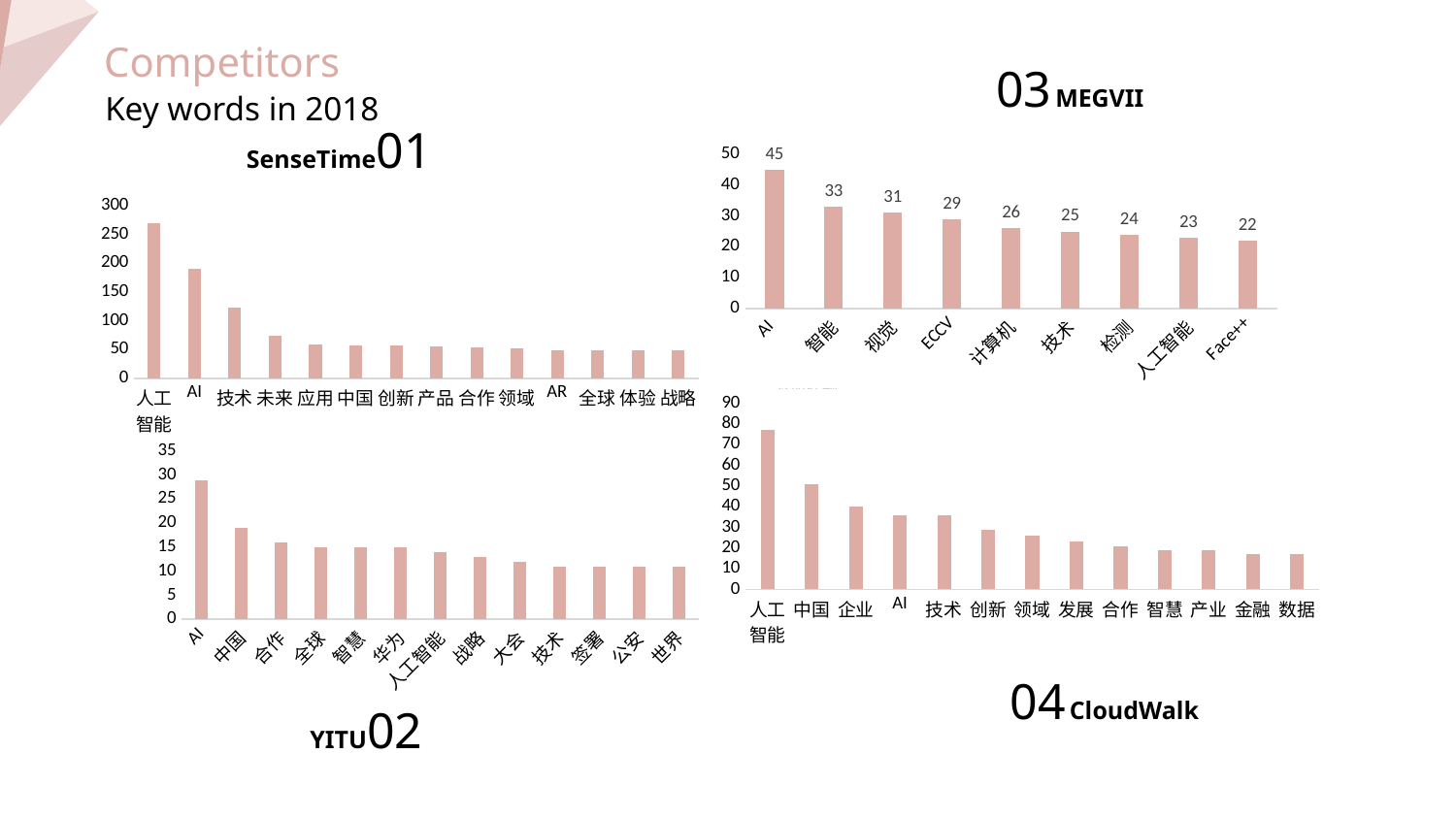
What kind of chart is the CloudWalk chart? bar chart In the SenseTime chart, how many keywords are plotted? 14 In the MEGVII chart, what is the value for ECCV? 29 In the MEGVII chart, how many keywords are plotted? 9 In the CloudWalk chart, is the value for 人工智能 greater or less than 70? greater In the MEGVII chart, what is the value for Face++? 22 In the MEGVII chart, which keyword has the lowest value? Face++ In the SenseTime chart, which keyword has the highest value? 人工智能 In the MEGVII chart, what is the value for AI? 45 In the MEGVII chart, what is the difference between the values for AI and 智能? 12 In the YITU chart, is the value for AI greater or less than 25? greater In the SenseTime chart, is the value for AI greater or less than 200? less